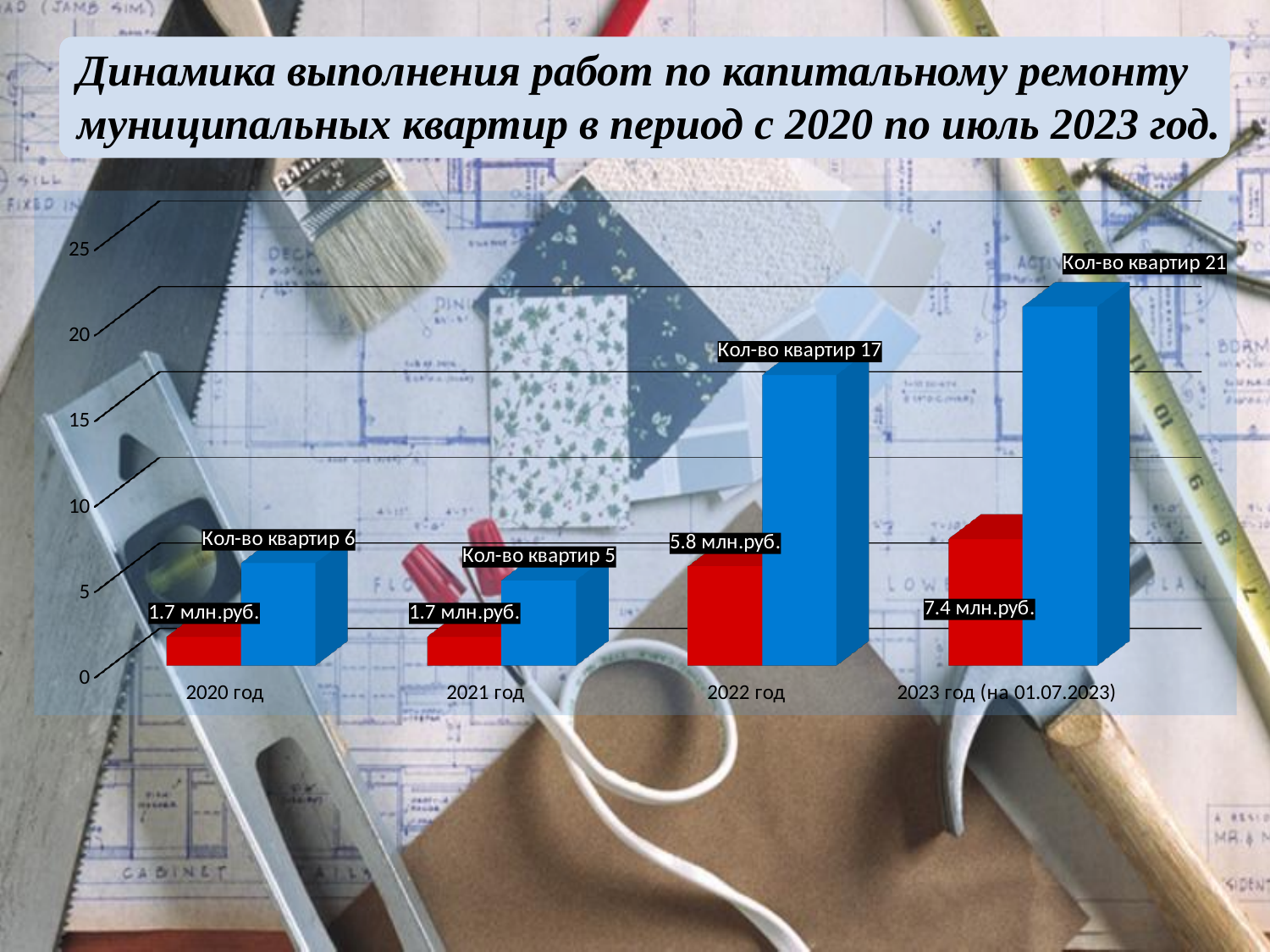
What is the number of apartments (Кол-во квартир) shown for 2022 год? 17 What is the difference in the number of apartments between 2023 год (на 01.07.2023) and 2022 год? 4 Which year has the lowest number of apartments (Кол-во квартир)? 2021 год Does the number of apartments rise or fall from 2021 год to 2023 год (на 01.07.2023)? rise How many year categories are shown on the x axis of the chart? 4 Which is larger: the number of apartments in 2022 год or in 2021 год? 2022 год Which year has the highest number of apartments (Кол-во квартир)? 2023 год (на 01.07.2023) What is the number of apartments (Кол-во квартир) shown for 2020 год? 6 What amount in млн.руб. is labelled for 2021 год? 1.7 млн.руб. What colour are the bars labelled with млн.руб. values? red What amount in млн.руб. is labelled for 2023 год (на 01.07.2023)? 7.4 млн.руб. What kind of chart is shown on the slide? bar chart